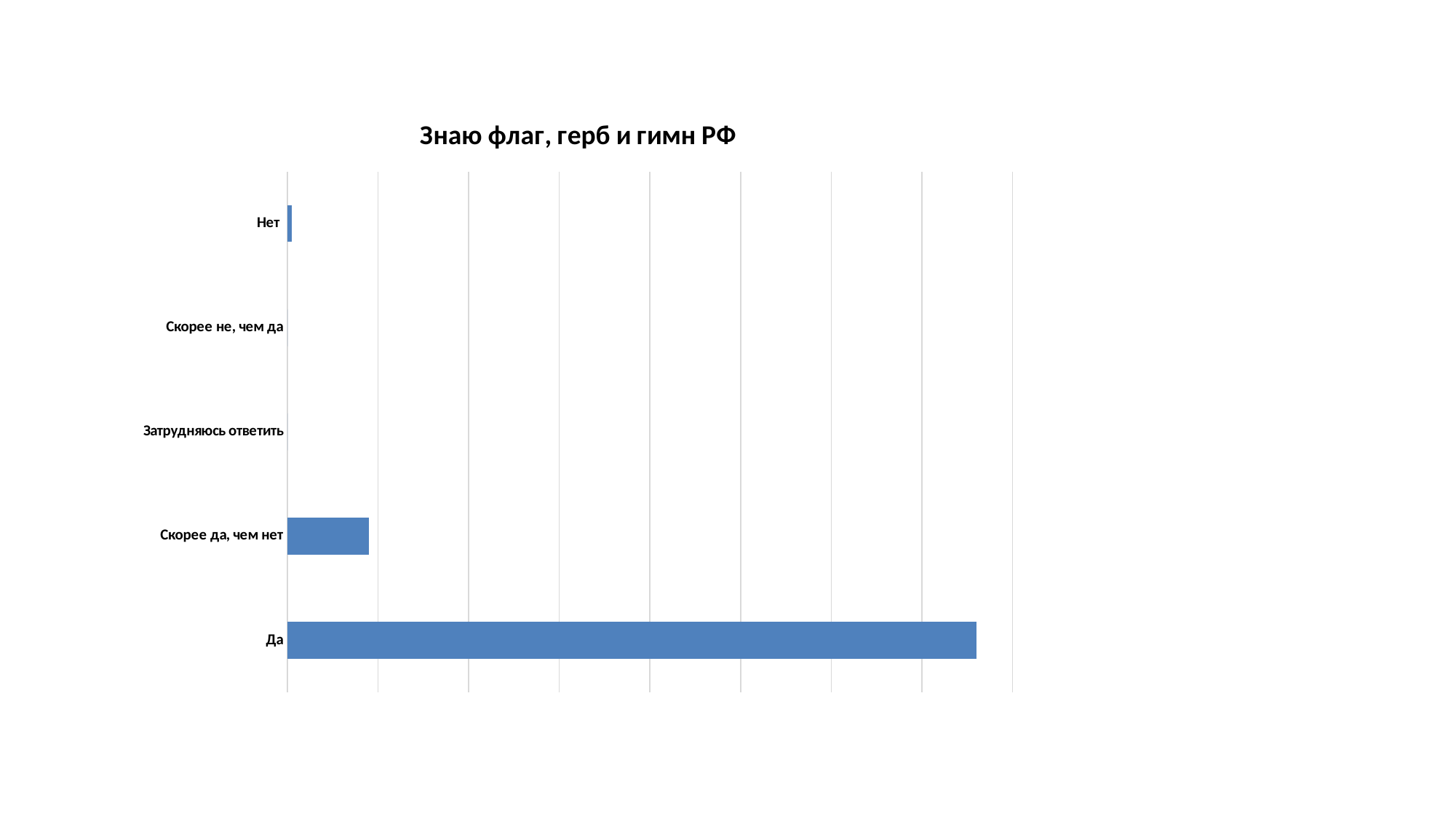
Which category has the longest bar? Да What is the title of the chart? Знаю флаг, герб и гимн РФ Which is larger, the value for Нет or the value for Да? Да Which is larger, the value for Скорее да, чем нет or the value for Нет? Скорее да, чем нет Which category has the second-longest bar? Скорее да, чем нет Among the categories with a visible bar, which has the shortest bar? Нет What kind of chart is shown on the slide? bar chart How many categories are listed on the vertical axis of the chart? 5 Which categories show no visible bar in the chart? Скорее не, чем да; Затрудняюсь ответить